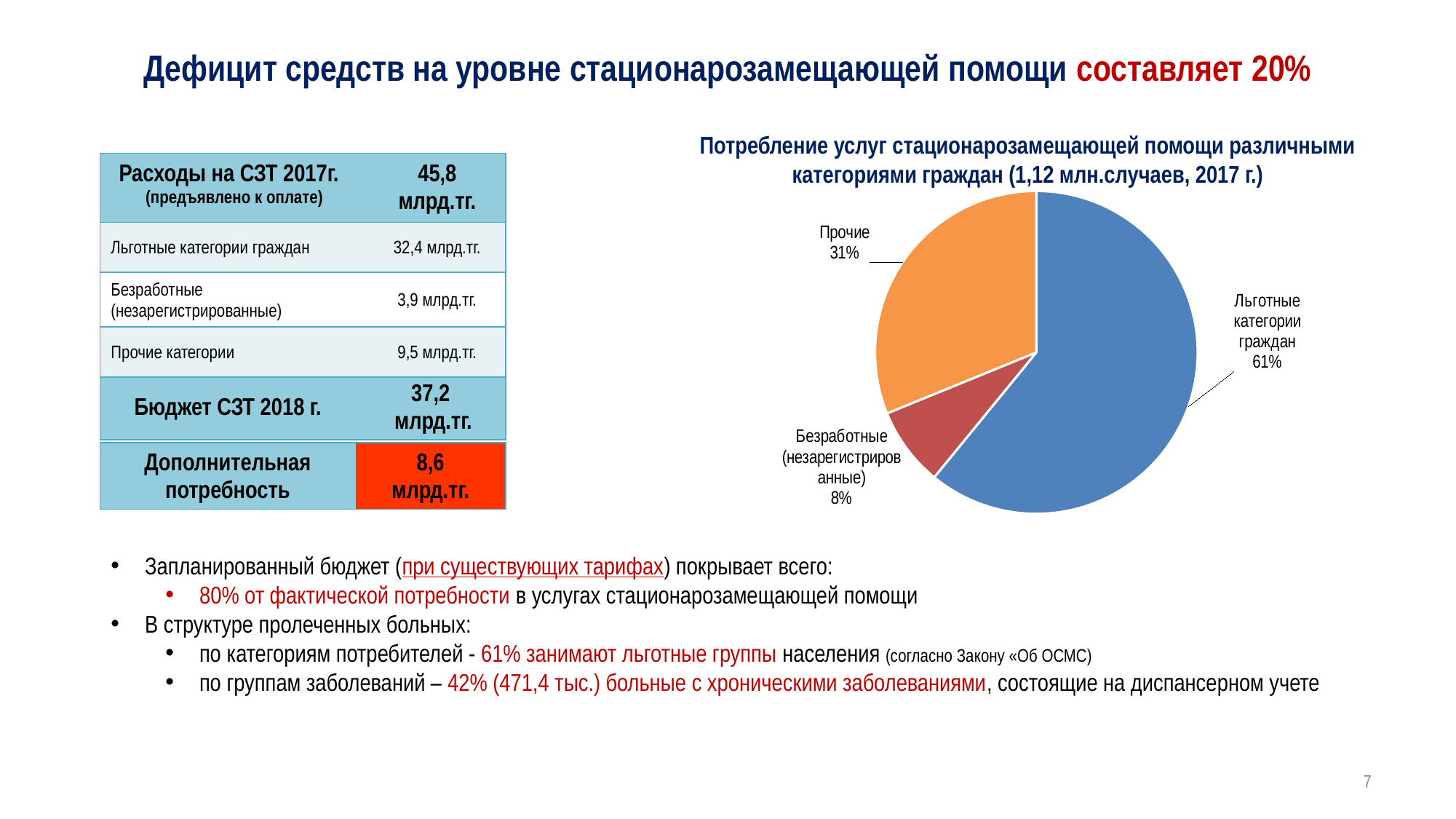
What is the difference in percentage points between the Льготные категории граждан slice and the Прочие slice? 30 How many categories are shown in the pie chart? 3 Which category has the smallest slice in the pie chart? Безработные (незарегистрированные) What is the title of the pie chart? Потребление услуг стационарозамещающей помощи различными категориями граждан (1,12 млн.случаев, 2017 г.) Which slice is larger: Прочие or Безработные (незарегистрированные)? Прочие What kind of chart is shown on the slide? Pie chart Which category has the largest slice in the pie chart? Льготные категории граждан What share of the pie chart is taken by Прочие? 31% What share of the pie chart is taken by Льготные категории граждан? 61% What colour is the Льготные категории граждан slice in the pie chart? Blue What share of the pie chart is taken by Безработные (незарегистрированные)? 8% What is the combined share of the Прочие and Безработные (незарегистрированные) slices? 39%